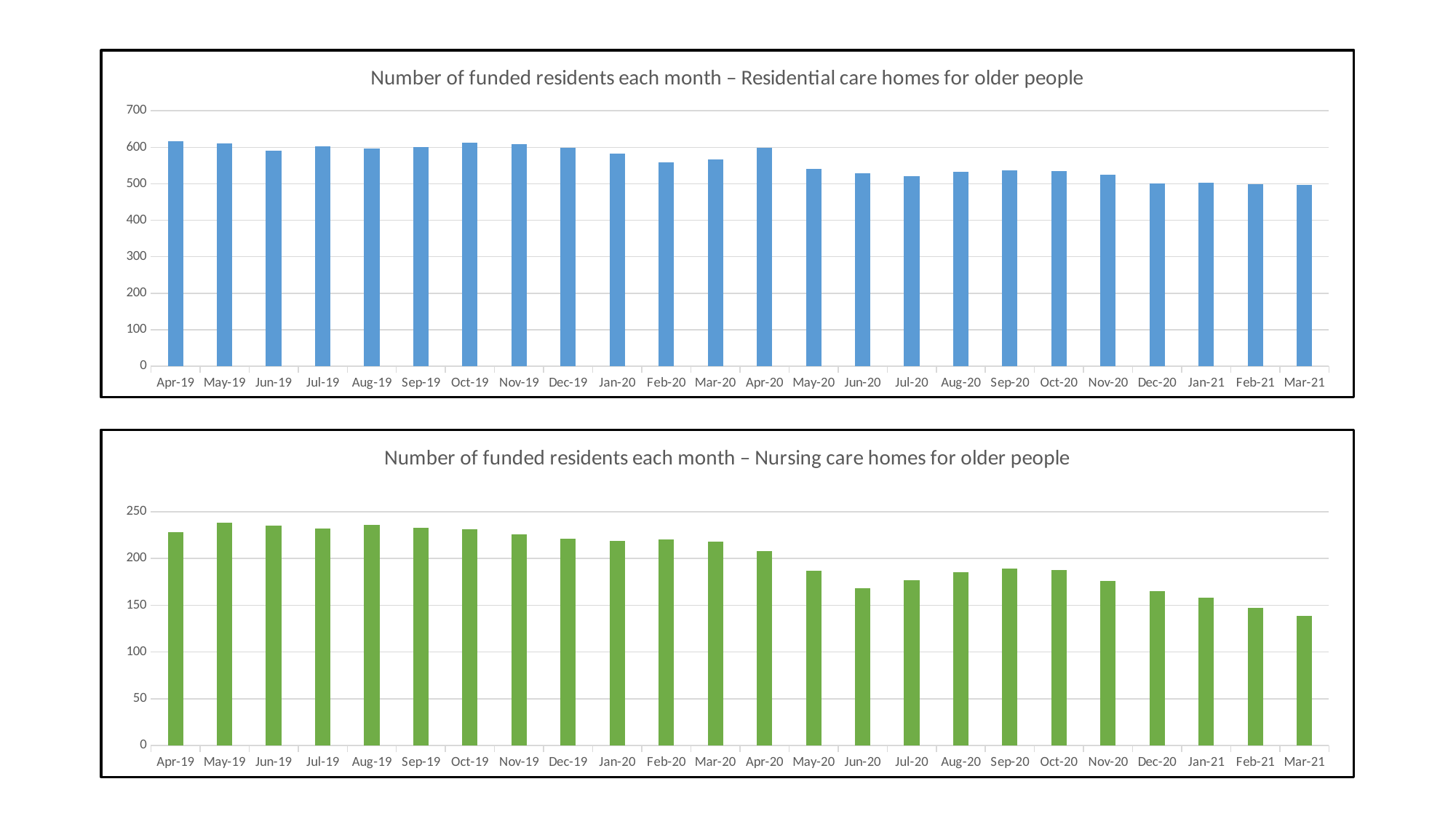
In the top chart (Residential care homes), which is larger, the value for Apr-19 or the value for Mar-21? Apr-19 In the bottom chart (Nursing care homes), is the value for Mar-21 greater or less than 150? less In the top chart (Residential care homes), is the value for Apr-19 greater or less than 600? greater In the top chart (Residential care homes), is the value for Jun-20 greater or less than 500? greater In the bottom chart (Nursing care homes), which is larger, the value for Jun-20 or the value for Sep-20? Sep-20 What type of chart is the top chart, 'Number of funded residents each month – Residential care homes for older people'? bar chart In the bottom chart (Nursing care homes), which month has the lowest value? Mar-21 What is the title of the bottom chart on the slide? Number of funded residents each month – Nursing care homes for older people In the top chart (Residential care homes), do the values generally rise or fall from Apr-19 to Mar-21? fall How many months are shown on the x axis of the top chart (Residential care homes)? 24